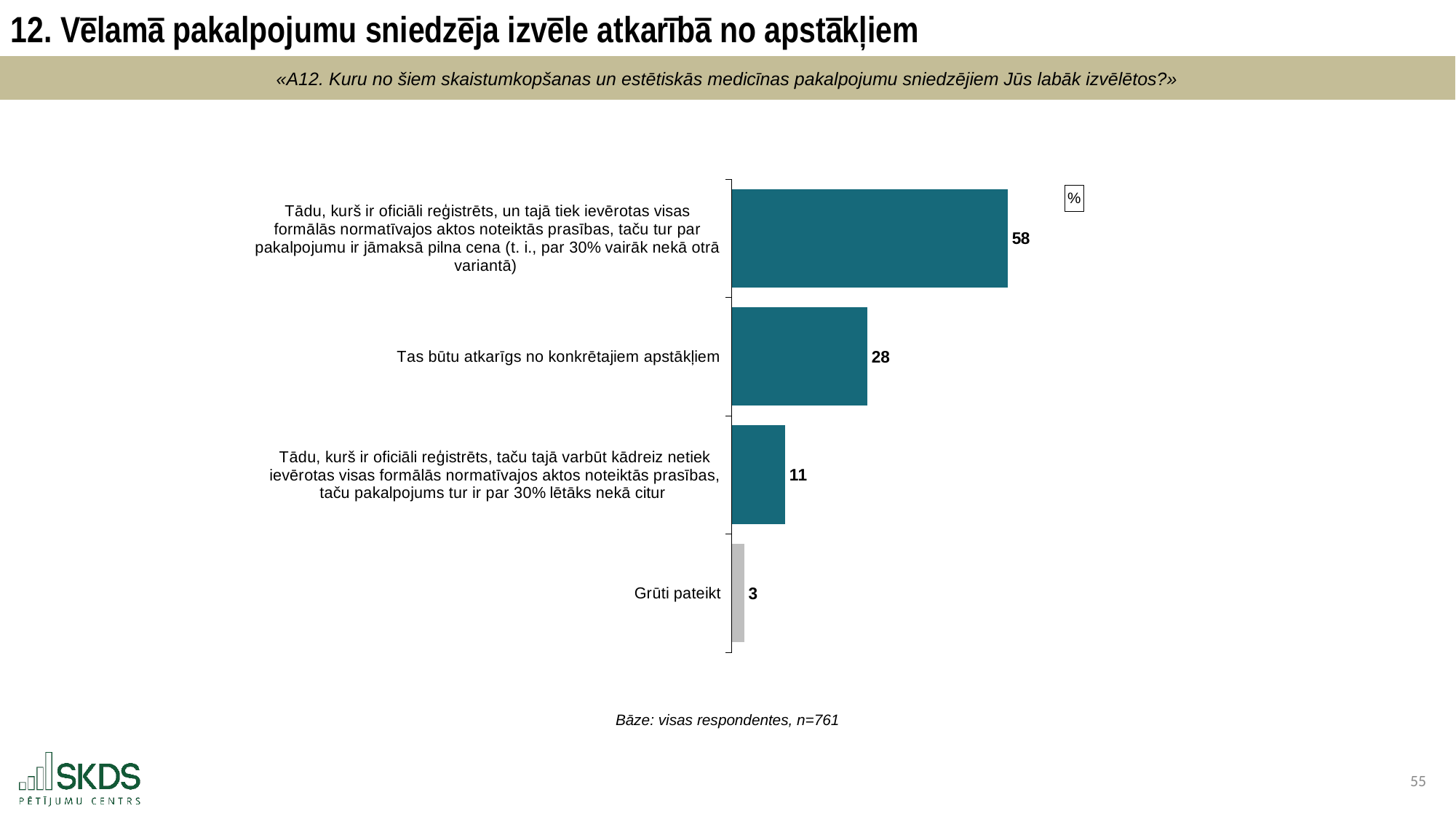
What is the base (sample size) stated below the chart? visas respondentes, n=761 What is the difference between the value for the cheaper, possibly non-compliant provider (11) and "Grūti pateikt" (3)? 8 What is the difference between the highest value (58) and the value for "Tas būtu atkarīgs no konkrētajiem apstākļiem" (28)? 30 What is the value for "Tas būtu atkarīgs no konkrētajiem apstākļiem"? 28 How many categories are shown in the chart? 4 What is the value for the option of an officially registered provider that may sometimes not follow all formal requirements but is 30% cheaper? 11 What kind of chart is shown on the slide? Bar chart Which is larger: the value for "Tas būtu atkarīgs no konkrētajiem apstākļiem" or the value for the cheaper, possibly non-compliant provider? Tas būtu atkarīgs no konkrētajiem apstākļiem What is the value for "Grūti pateikt"? 3 Which category has the lowest value? Grūti pateikt What is the value for the option of an officially registered provider that follows all formal requirements but charges the full price (30% more)? 58